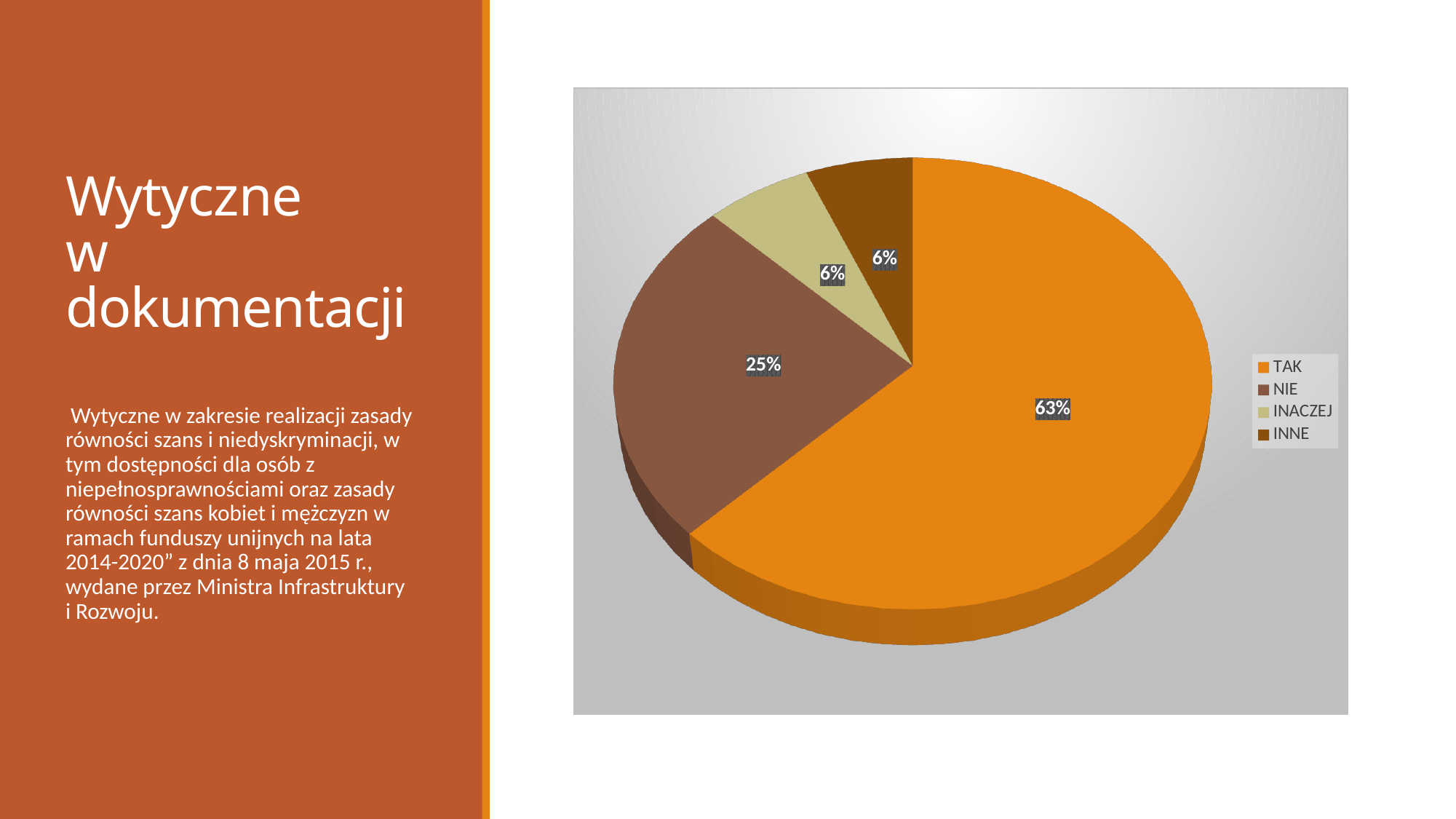
What percentage of the pie chart is the INNE slice? 6% What percentage of the pie chart is the NIE slice? 25% Which slice is larger, NIE or INACZEJ? NIE What colour is the TAK slice in the pie chart? orange What percentage of the pie chart is the INACZEJ slice? 6% What percentage of the pie chart is the TAK slice? 63% How many entries does the legend of the pie chart list? 4 How many slices does the pie chart have? 4 What is the combined share of the INACZEJ and INNE slices? 12% What is the difference in percentage points between the TAK and NIE slices? 38 Which category has the largest share of the pie chart? TAK What type of chart is shown on the slide? pie chart